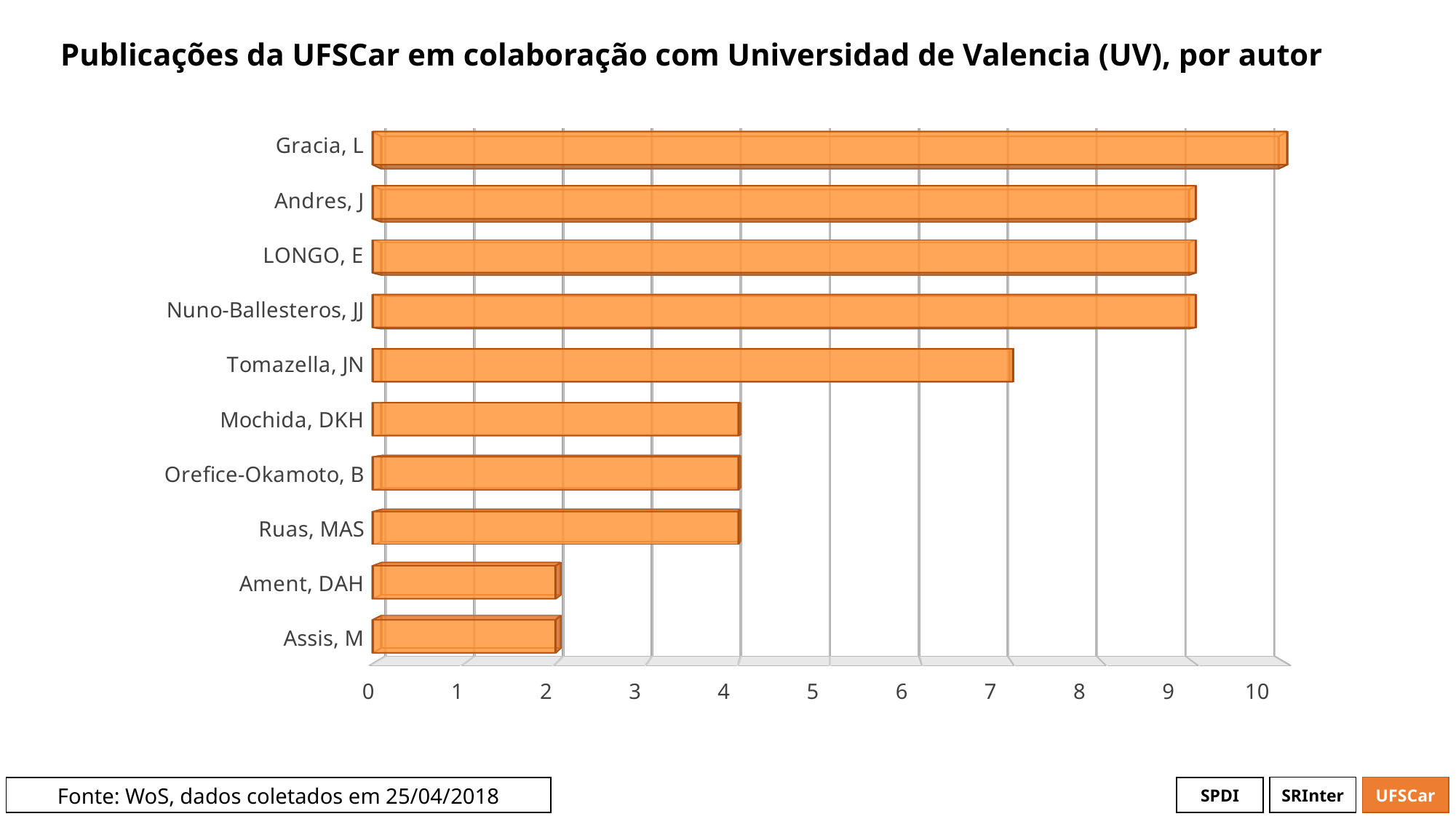
What is the title of the chart? Publicações da UFSCar em colaboração com Universidad de Valencia (UV), por autor Is the value for Andres, J greater or less than 8? greater Which author has the highest number of publications? Gracia, L Who has more publications, Tomazella, JN or Ruas, MAS? Tomazella, JN What is the difference between the publications of Gracia, L and Tomazella, JN? 3 Do the bar values increase or decrease going from the top author to the bottom author? decrease How many publications does Assis, M have? 2 How many authors are listed on the chart? 10 Is the value for Mochida, DKH greater or less than 5? less How many publications does Gracia, L have? 10 What kind of chart is shown on the slide? bar chart How many publications does Tomazella, JN have? 7